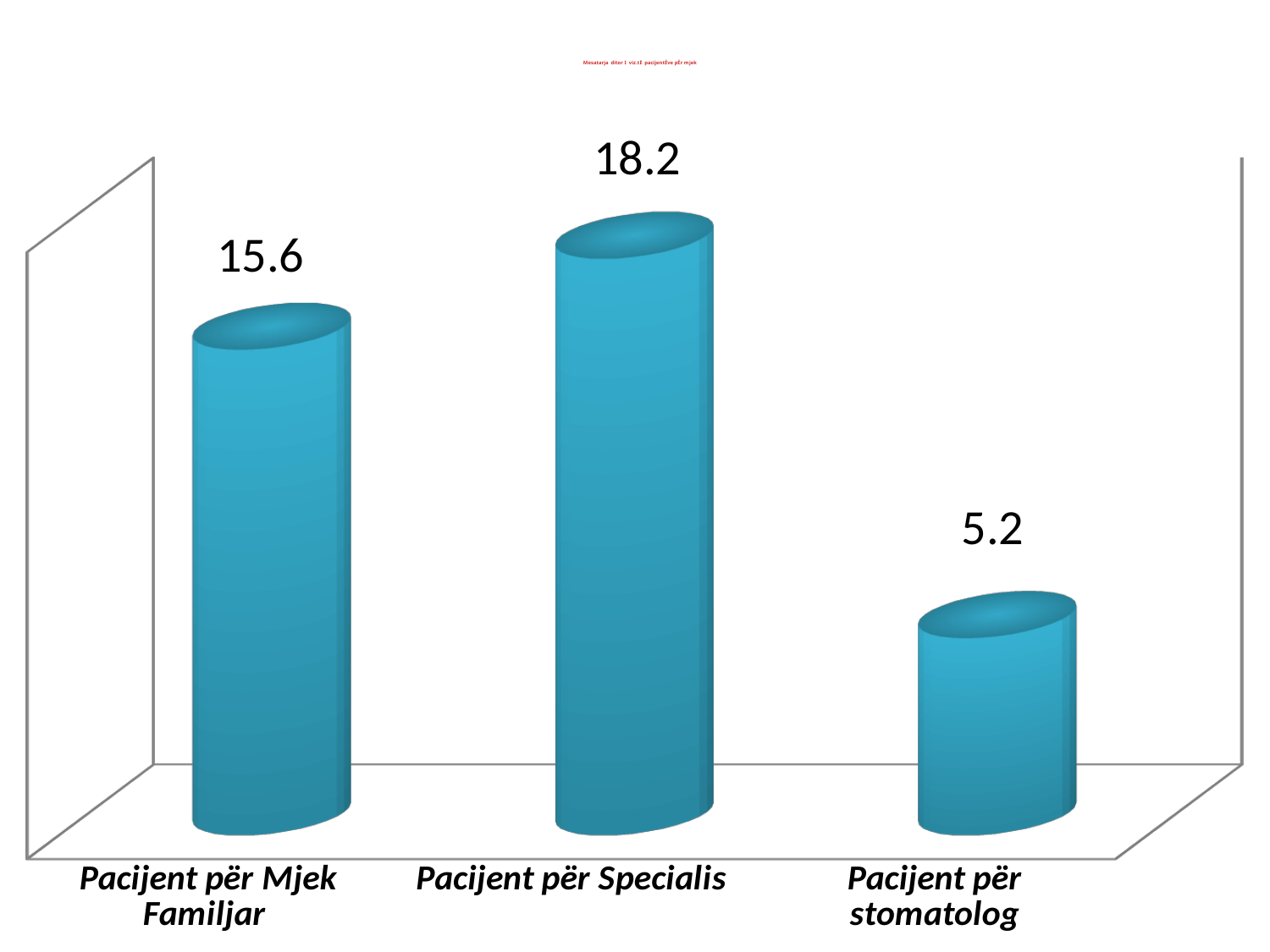
Which is larger, the value for Pacijent për Specialis or the value for Pacijent për Mjek Familjar? Pacijent për Specialis Which is larger, the value for Pacijent për Mjek Familjar or the value for Pacijent për stomatolog? Pacijent për Mjek Familjar What is the value for Pacijent për Mjek Familjar? 15.6 What kind of chart is shown on the slide? Bar chart What is the value for Pacijent për stomatolog? 5.2 How many categories are shown in the chart? 3 What colour are the bars in the chart? Blue Which category has the lowest value? Pacijent për stomatolog What is the difference between the values for Pacijent për Mjek Familjar and Pacijent për stomatolog? 10.4 Which category has the highest value? Pacijent për Specialis What is the value for Pacijent për Specialis? 18.2 What is the difference between the values for Pacijent për Specialis and Pacijent për Mjek Familjar? 2.6